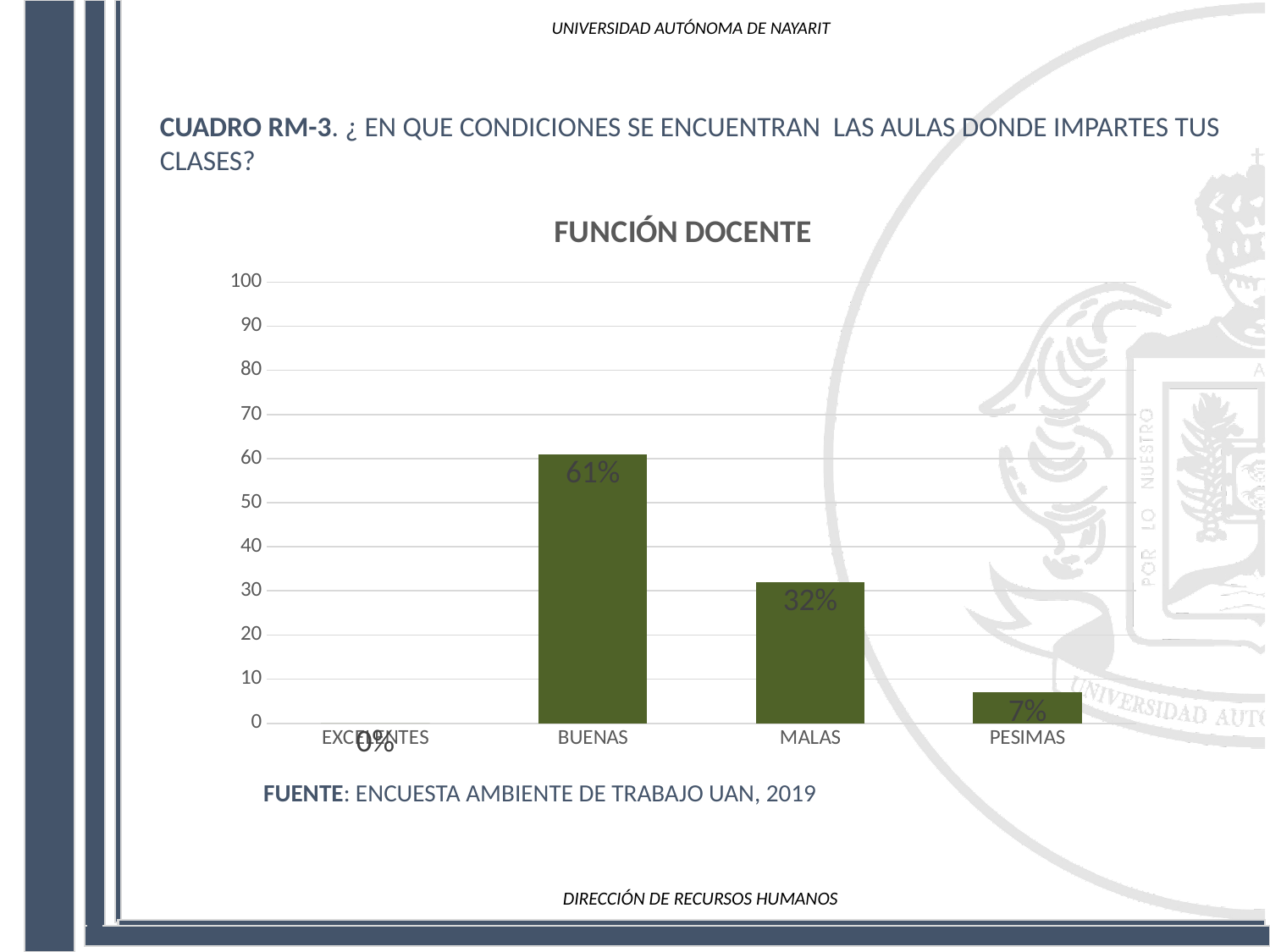
How many categories are shown on the x axis? 4 What is the value for MALAS? 32% What kind of chart is shown on the slide? bar chart Is the value for BUENAS greater or less than 50? greater What is the value for BUENAS? 61% Which category has the lowest value? EXCELENTES What is the difference between the values for MALAS and PESIMAS? 25% Which category has the highest value? BUENAS What is the value for PESIMAS? 7% What is the difference between the values for BUENAS and MALAS? 29% What is the title of the chart? FUNCIÓN DOCENTE Which is larger, the value for MALAS or the value for PESIMAS? MALAS